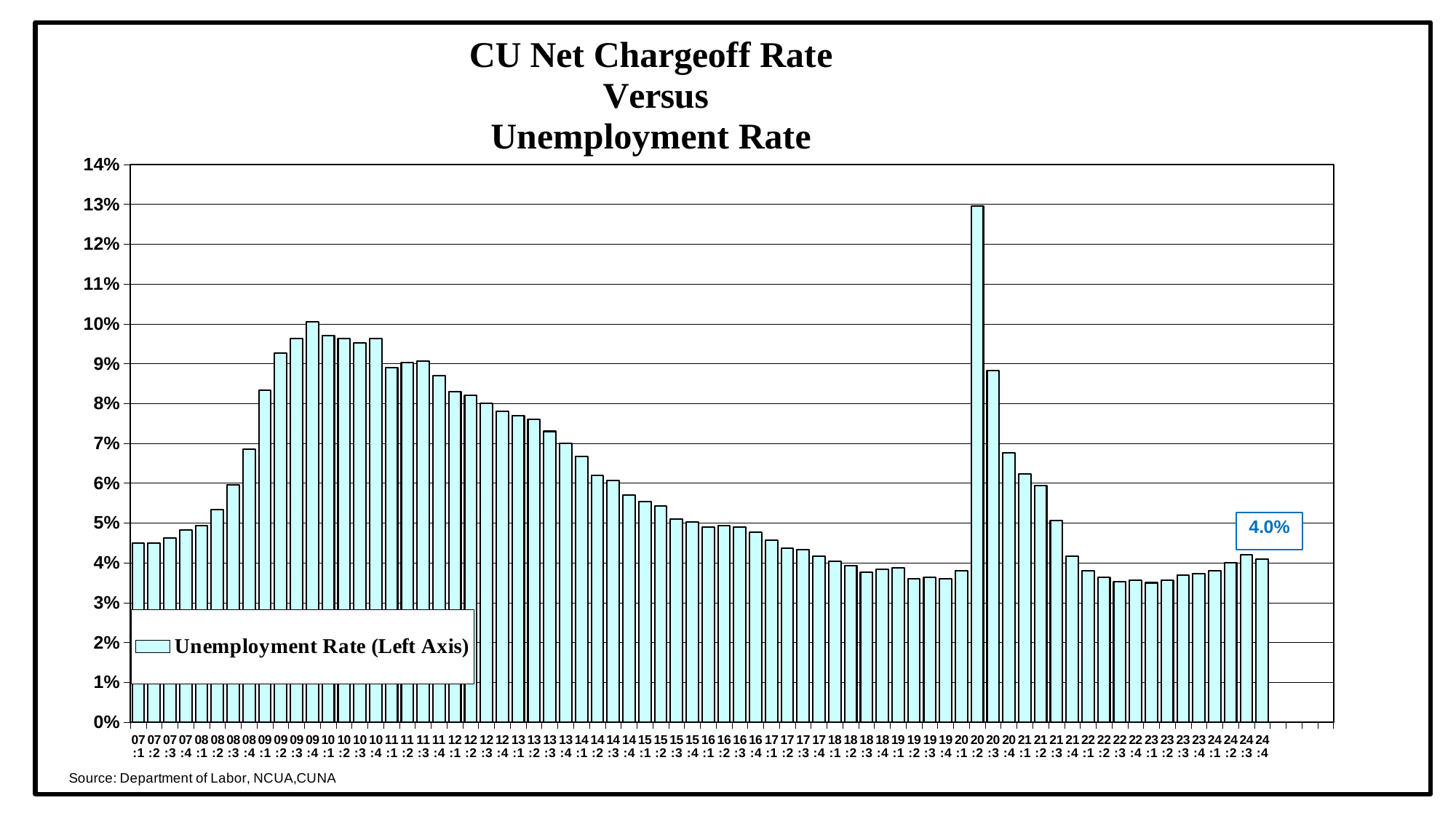
Do the unemployment rate values rise or fall from 09:4 to 19:4? fall Is the value for 09:4 greater or less than 9%? greater What series name appears in the legend? Unemployment Rate (Left Axis) Is the value for 23:1 greater or less than 4%? less What is the unemployment rate value labeled for 24:4? 4.0% How many series does the legend list? 1 What is the title of the chart? CU Net Chargeoff Rate Versus Unemployment Rate Which quarter has the highest unemployment rate bar? 20:2 Is the value for 07:1 greater or less than 5%? less What kind of chart is shown on the slide? bar chart Which is larger, the value for 20:2 or the value for 09:4? 20:2